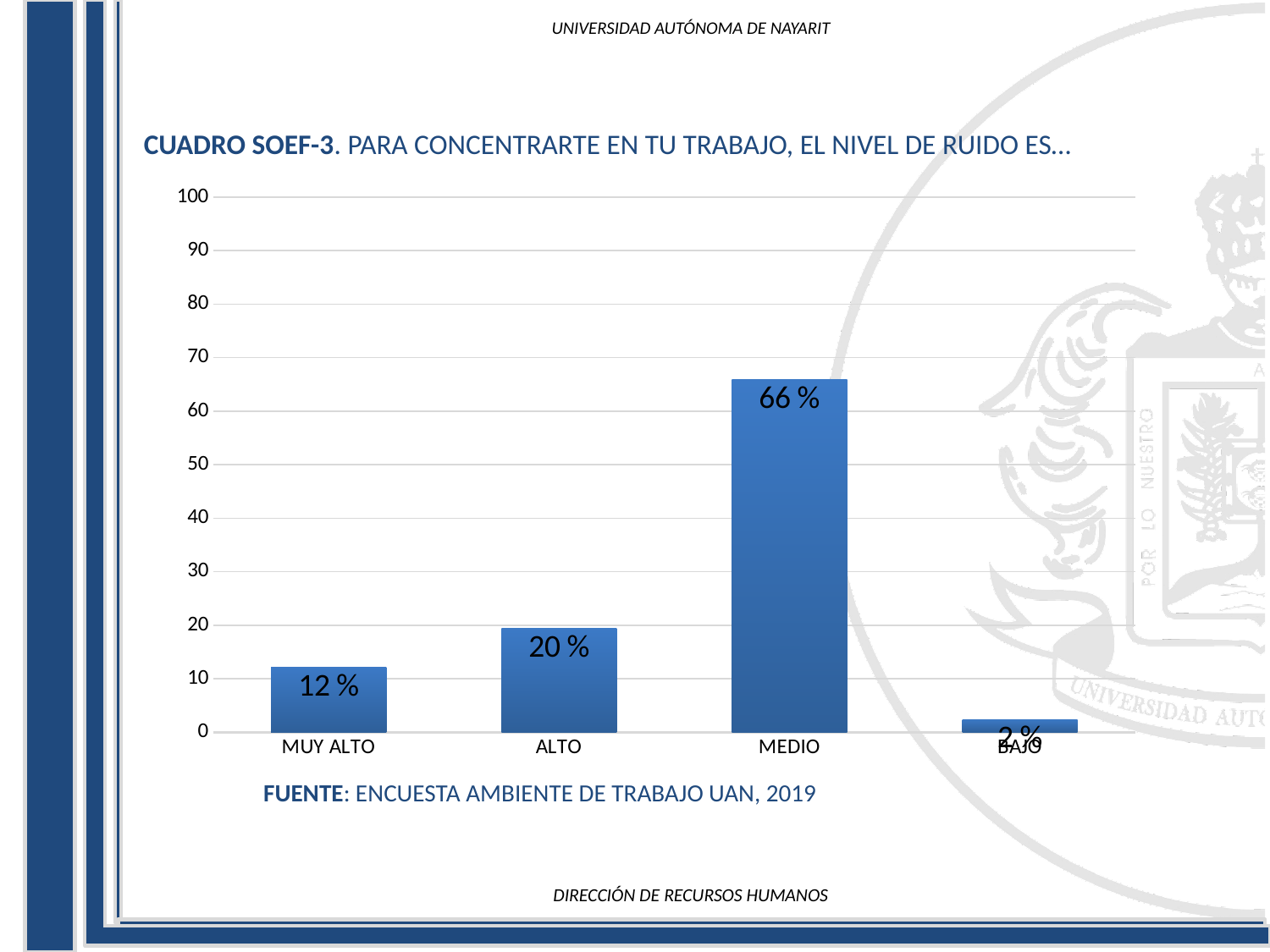
Which is larger, the value for MUY ALTO or the value for ALTO? ALTO What kind of chart is shown on the slide? bar chart Is the value for MEDIO greater or less than 50? greater What is the value for ALTO? 20 % What is the value for MEDIO? 66 % What is the value for MUY ALTO? 12 % What source is cited below the chart? ENCUESTA AMBIENTE DE TRABAJO UAN, 2019 Which category has the highest value? MEDIO What is the difference between the values for ALTO and MUY ALTO? 8 % Which category has the lowest value? BAJO How many categories are shown on the x axis? 4 What is the difference between the values for MEDIO and ALTO? 46 %